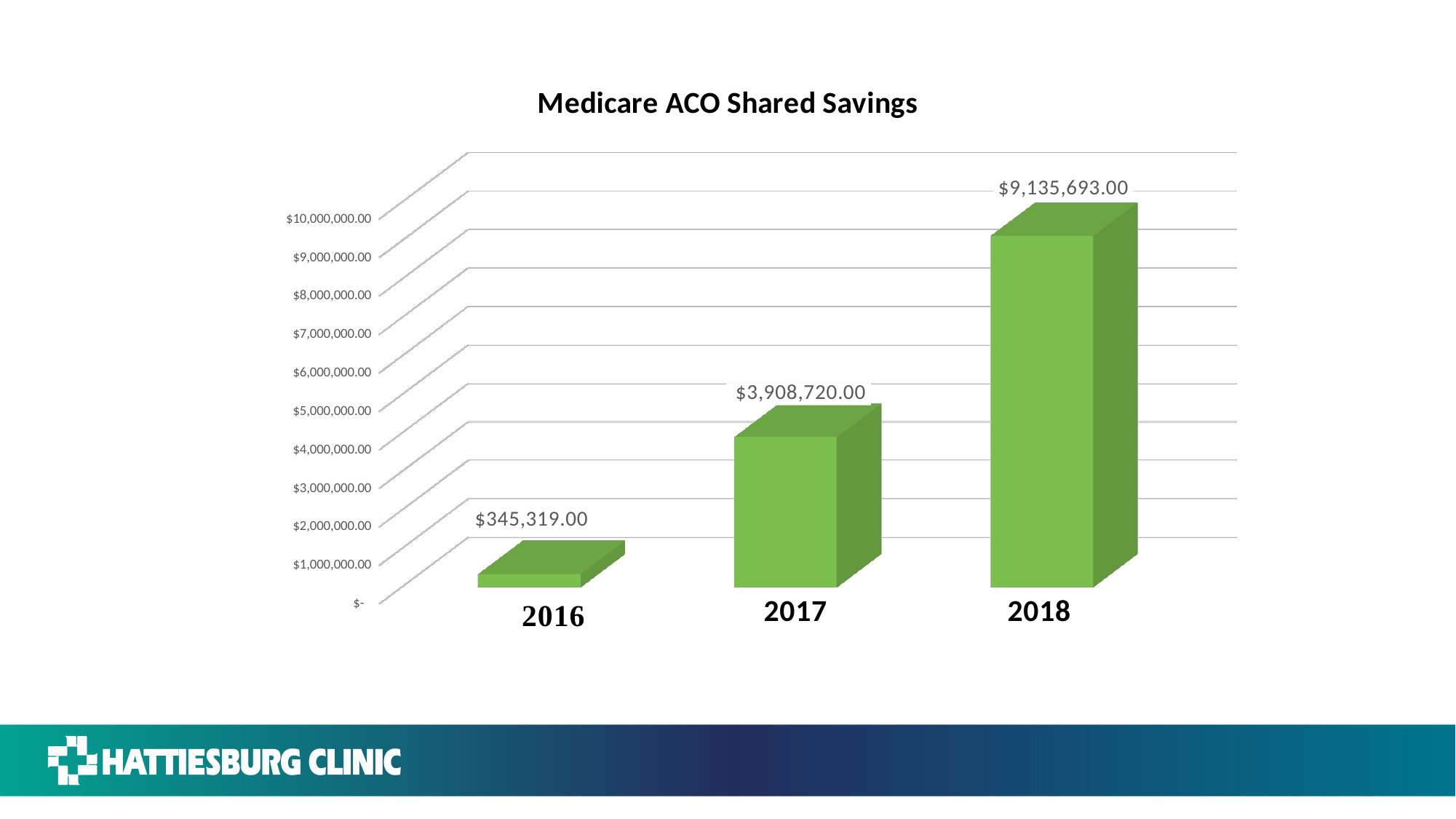
Which year has the highest shared savings? 2018 Is the value for 2018 greater or less than $8,000,000.00? greater What is the difference between the 2017 and 2016 values? $3,563,401.00 What is the value for 2016? $345,319.00 What is the value for 2018? $9,135,693.00 Which is larger, the value for 2017 or the value for 2016? 2017 What is the value for 2017? $3,908,720.00 Which year has the lowest shared savings? 2016 What is the difference between the 2018 and 2017 values? $5,226,973.00 How many years are shown on the chart? 3 Do the values rise or fall from 2016 to 2018? rise What kind of chart is this? bar chart